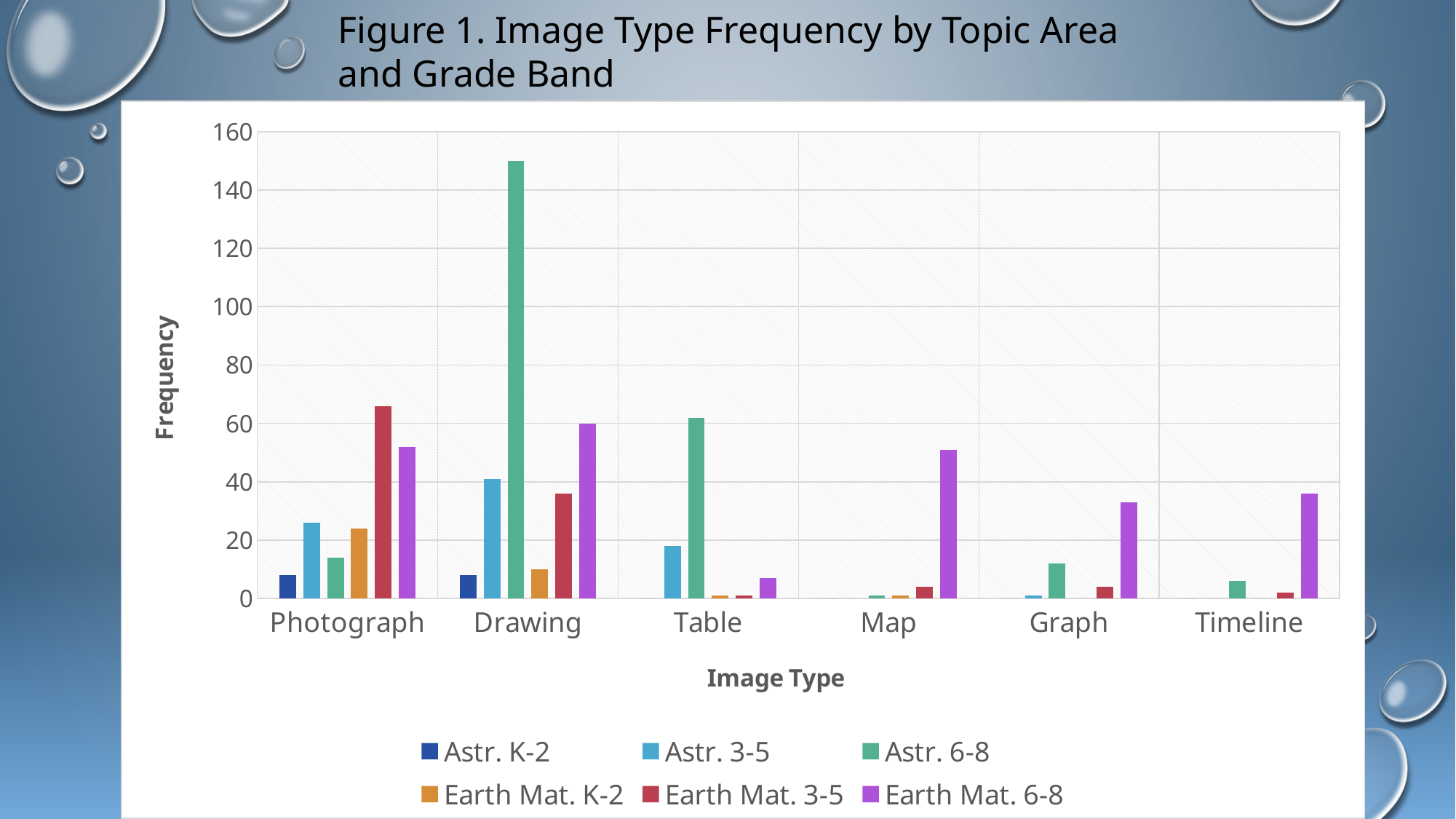
What is the label of the y axis? Frequency Is the value for Astr. 6-8 for Drawing greater or less than 140? greater What kind of chart is shown on the slide? bar chart Is the value for Earth Mat. 6-8 for Map greater or less than 40? greater Which is larger for Table: Astr. 6-8 or Earth Mat. 6-8? Astr. 6-8 How many series does the legend list? 6 Which series has the highest bar for Drawing? Astr. 6-8 What is the title of the chart? Figure 1. Image Type Frequency by Topic Area and Grade Band Is the value for Astr. 3-5 for Table greater or less than 20? less How many image type categories are shown on the x axis? 6 Which series has the highest bar for Photograph? Earth Mat. 3-5 Which image type has the tallest bar in the chart? Drawing